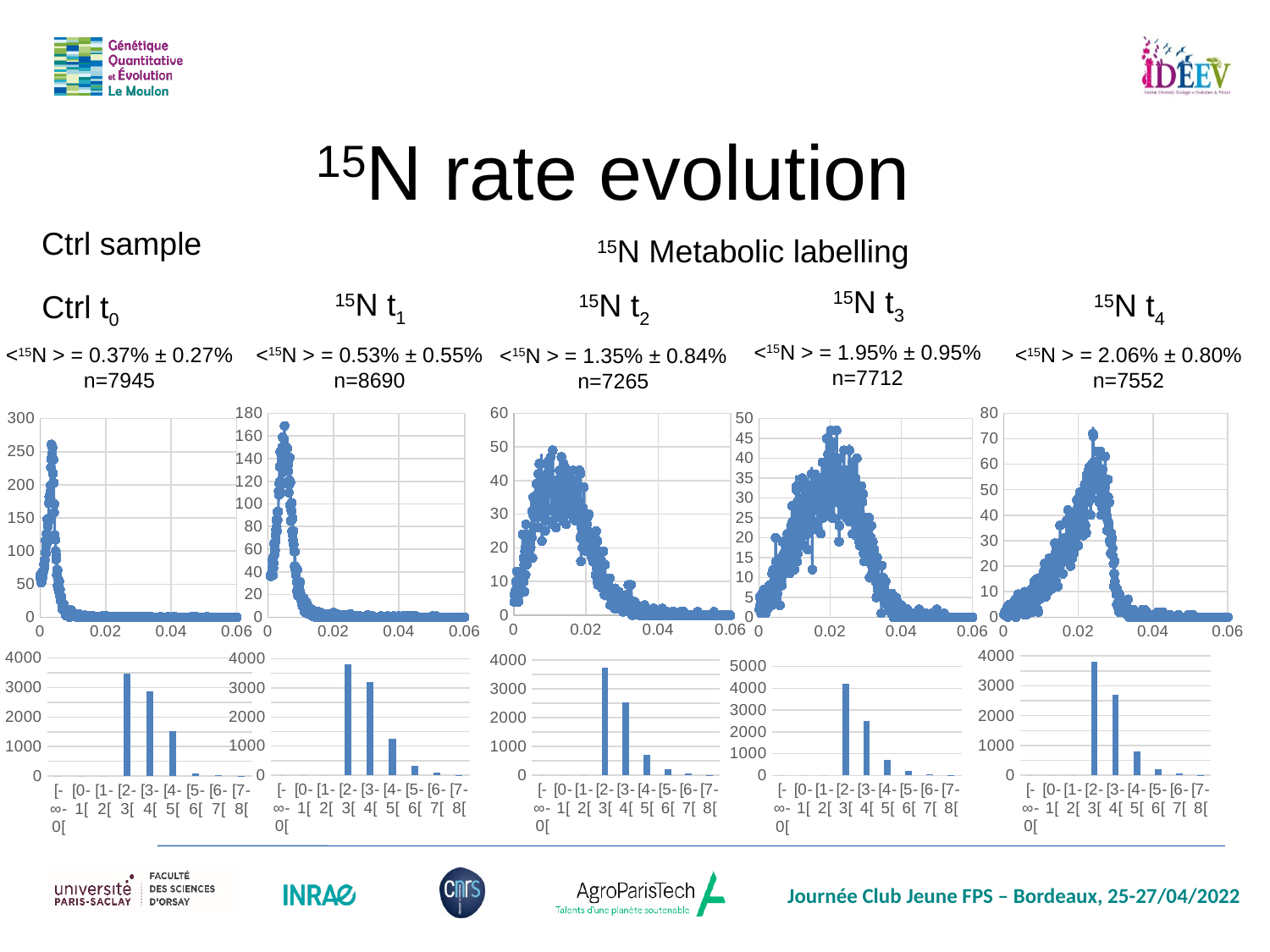
What is the highest y-axis tick shown on the top scatter chart under Ctrl t0? 300 In the bottom bar chart under 15N t4, is the value for [4-5[ greater or less than 1000? less In the bottom bar chart under 15N t1, do the bar values rise or fall from [2-3[ to [7-8[? fall In the bottom bar chart under 15N t2, is the value for [3-4[ greater or less than 3000? less In the bottom bar chart under 15N t3, which is larger, the bar for [2-3[ or the bar for [3-4[? [2-3[ In the bottom bar chart under 15N t1, how many categories are shown on the x axis? 9 In the bottom bar chart under 15N t4, which category has the highest bar? [2-3[ What kind of chart is shown in the top row under 15N t2? scatter chart In the bottom bar chart under Ctrl t0, is the value for [2-3[ greater or less than 3000? greater What kind of chart is shown in the bottom row under Ctrl t0? bar chart How many charts are shown on the slide in total? 10 In the bottom bar chart under Ctrl t0, which category has the highest bar? [2-3[